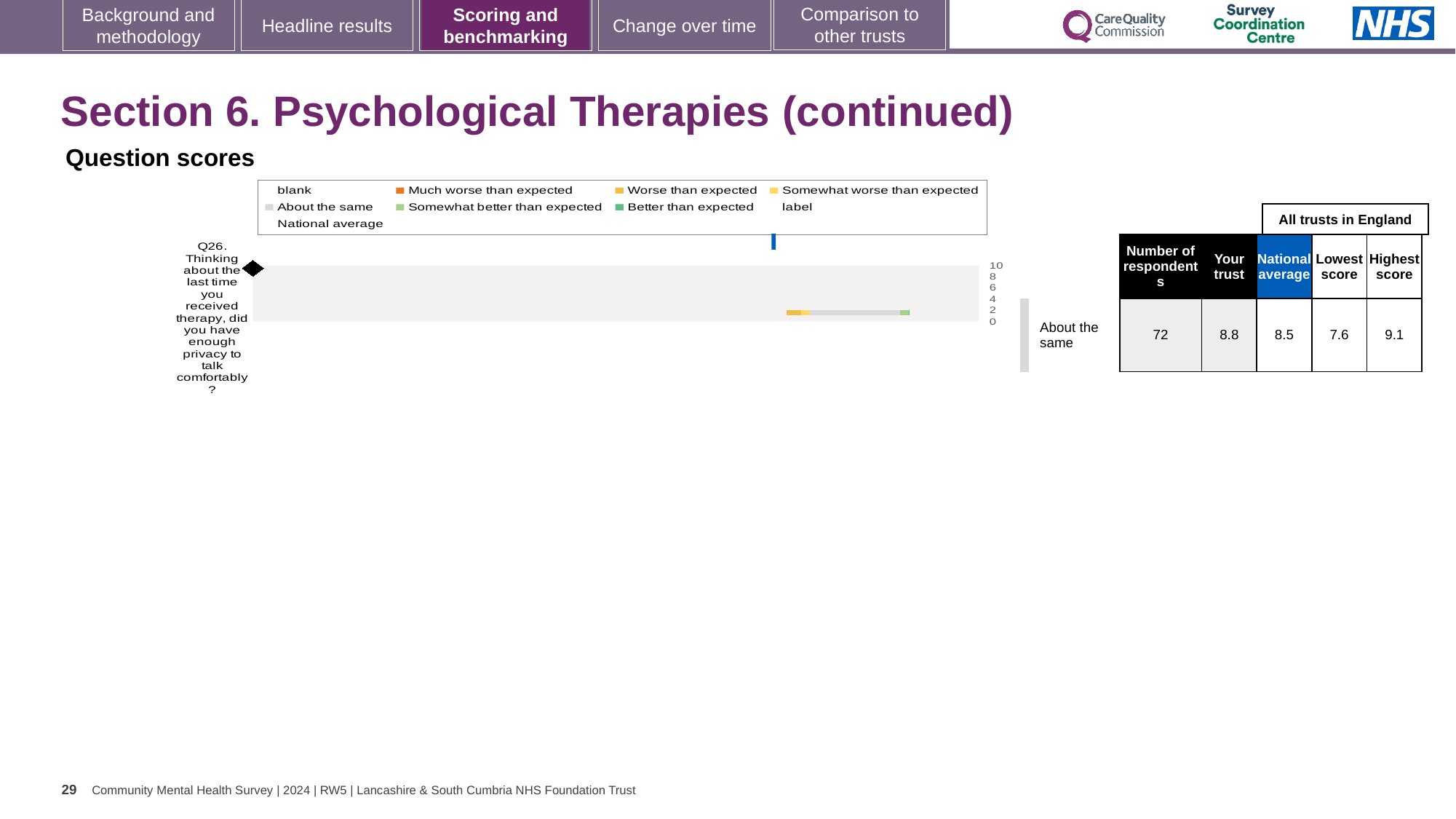
In the table beside the chart, how many respondents answered Q26? 72 What kind of chart is shown under 'Question scores'? bar chart In the table beside the chart, what is the lowest score among all trusts in England for Q26? 7.6 For Q26, which is larger: the 'Your trust' score or the national average? Your trust In the table beside the chart, what is the highest score among all trusts in England for Q26? 9.1 In the table beside the chart, what is the national average score for Q26? 8.5 How many entries does the legend of the Question scores chart list? 9 Which question is plotted in the Question scores chart? Q26. Thinking about the last time you received therapy, did you have enough privacy to talk comfortably? What is the highest tick value shown on the axis of the Question scores chart? 10 In the table beside the chart, what is the 'Your trust' score for Q26? 8.8 How many questions (categories) are plotted in the Question scores chart? 1 For Q26, what is the difference between the 'Your trust' score and the national average? 0.3